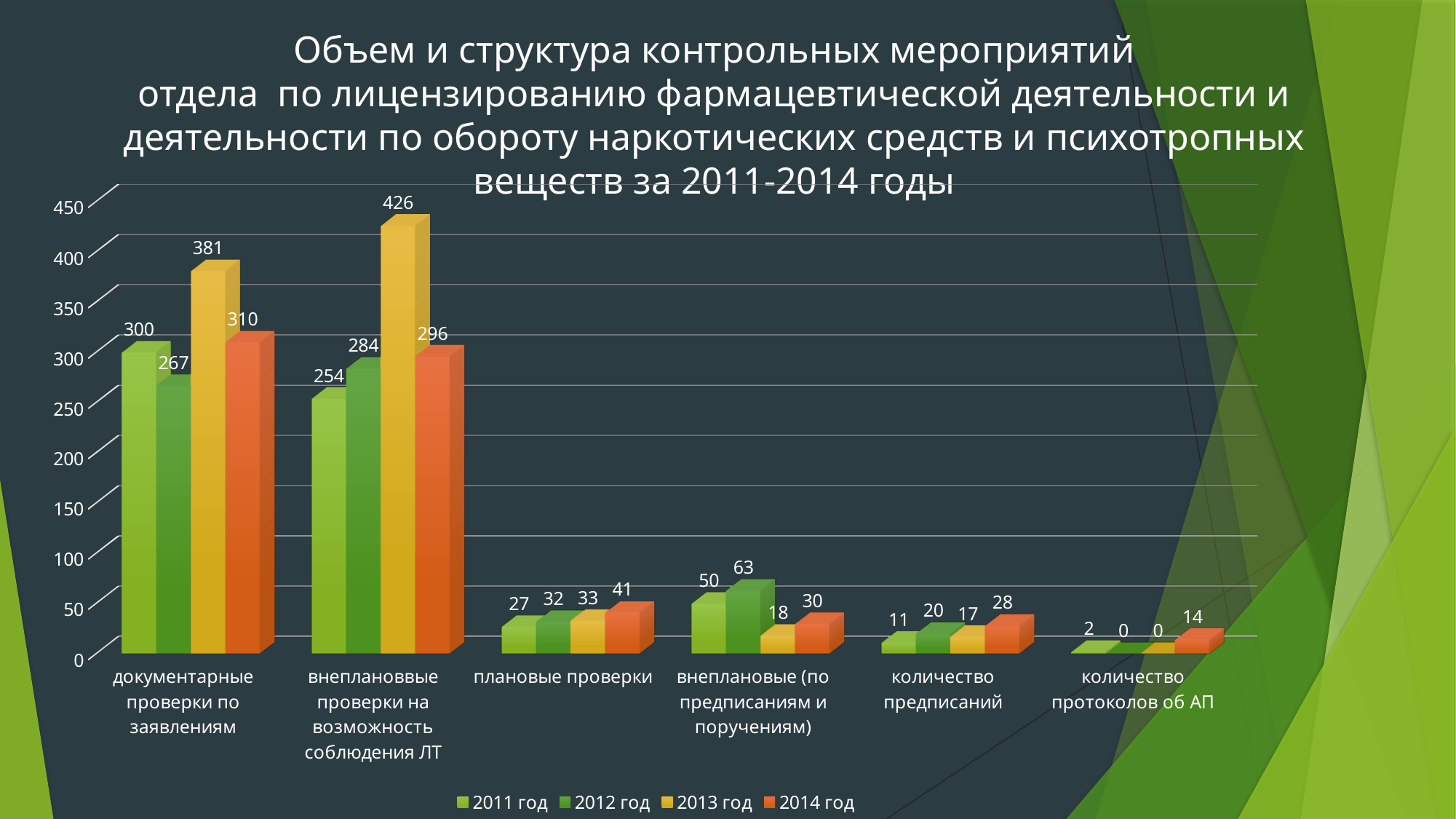
What is the value for 2012 год in the category 'документарные проверки по заявлениям'? 267 Which year has the highest value in the category 'внеплановые (по предписаниям и поручениям)'? 2012 год What is the difference between the 2013 год and 2011 год values for 'документарные проверки по заявлениям'? 81 Do the values for 'количество предписаний' rise or fall from 2013 год to 2014 год? rise How many categories are shown on the x axis? 6 What is the value for 2014 год in the category 'количество протоколов об АП'? 14 Which year has the lowest value in the category 'количество предписаний'? 2011 год Which colour represents 2014 год in the legend? orange Which is larger for 'плановые проверки': the 2014 год value or the 2011 год value? 2014 год How many series does the legend list? 4 What type of chart is shown on the slide? bar chart What is the value for 2013 год in the category 'внеплановвые проверки на возможность соблюдения ЛТ'? 426